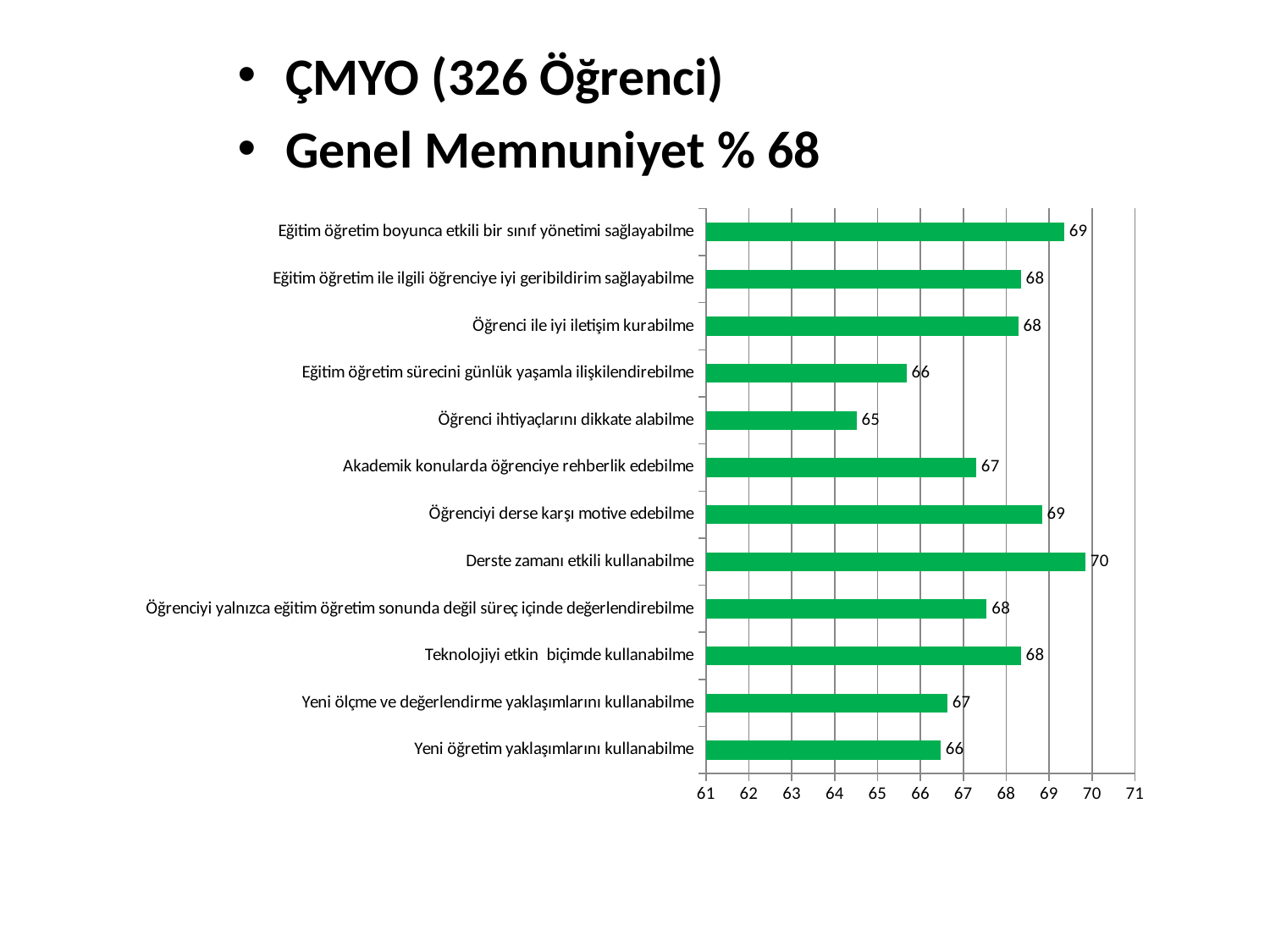
Which category has the highest value? Derste zamanı etkili kullanabilme What colour are the bars in the chart? green Is the value for "Eğitim öğretim boyunca etkili bir sınıf yönetimi sağlayabilme" greater or less than 65? greater What is the value for "Öğrenci ihtiyaçlarını dikkate alabilme"? 65 How many categories are plotted in the chart? 12 Which is larger: the value for "Öğrenciyi derse karşı motive edebilme" or the value for "Eğitim öğretim sürecini günlük yaşamla ilişkilendirebilme"? Öğrenciyi derse karşı motive edebilme Which category has the lowest value? Öğrenci ihtiyaçlarını dikkate alabilme What is the value for "Yeni öğretim yaklaşımlarını kullanabilme"? 66 What is the value for "Derste zamanı etkili kullanabilme"? 70 What is the difference between the values for "Derste zamanı etkili kullanabilme" and "Öğrenci ihtiyaçlarını dikkate alabilme"? 5 What type of chart is shown on the slide? bar chart What is the value for "Akademik konularda öğrenciye rehberlik edebilme"? 67